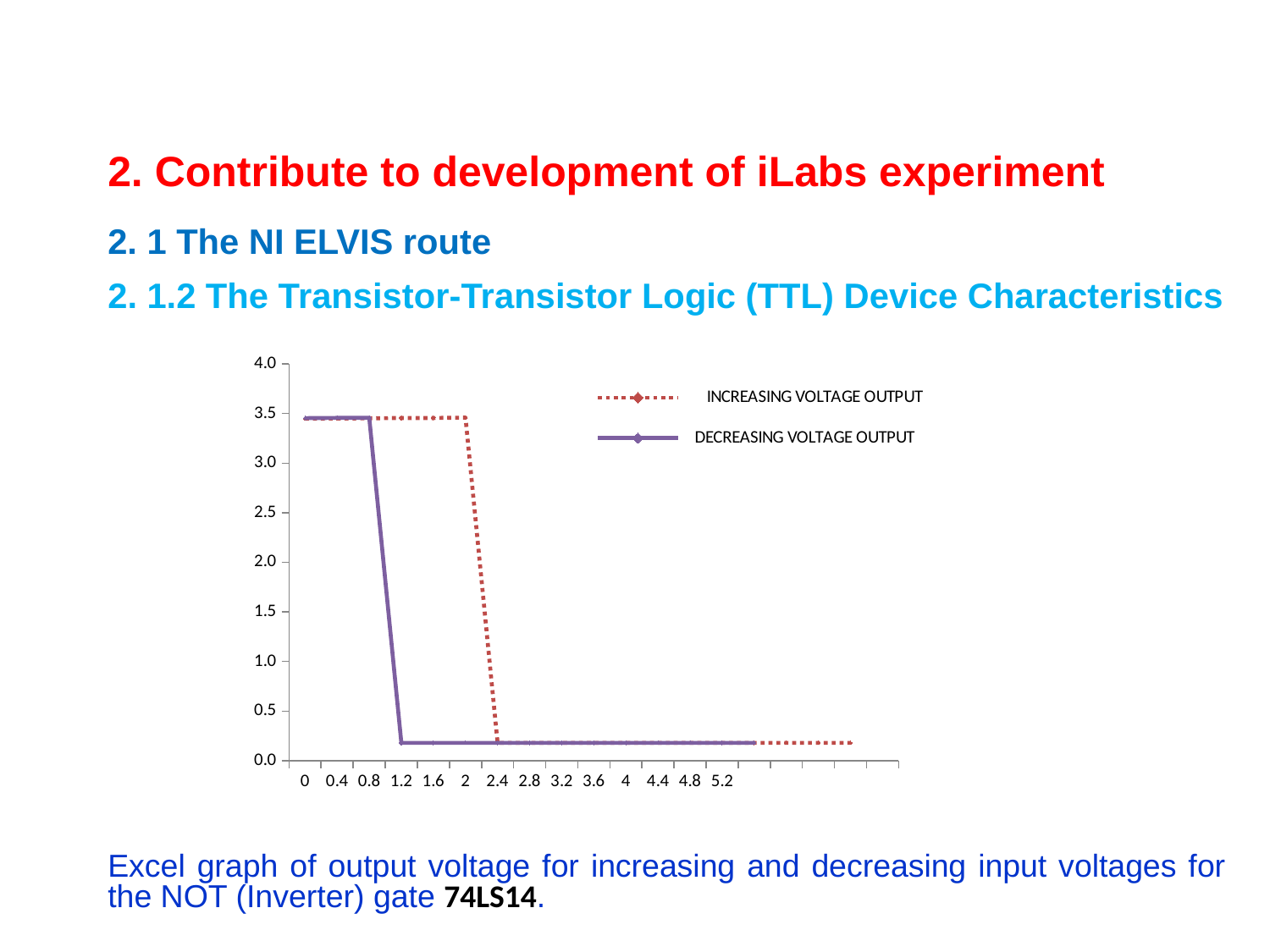
Is the value of DECREASING VOLTAGE OUTPUT at input 1.6 greater or less than 1.0? less Is the value of DECREASING VOLTAGE OUTPUT at input 0.4 greater or less than 3.0? greater Do the values of DECREASING VOLTAGE OUTPUT rise or fall as the input voltage increases along the x axis? fall What kind of chart is shown on the slide? line chart Is the value of INCREASING VOLTAGE OUTPUT at input 1.6 greater or less than 3.0? greater What are the two series named in the legend? INCREASING VOLTAGE OUTPUT and DECREASING VOLTAGE OUTPUT Which series is drawn as a dotted red line? INCREASING VOLTAGE OUTPUT Do the values of INCREASING VOLTAGE OUTPUT rise or fall as the input voltage increases along the x axis? fall At input 1.6, which series has the higher output voltage, INCREASING VOLTAGE OUTPUT or DECREASING VOLTAGE OUTPUT? INCREASING VOLTAGE OUTPUT How many series does the legend list? 2